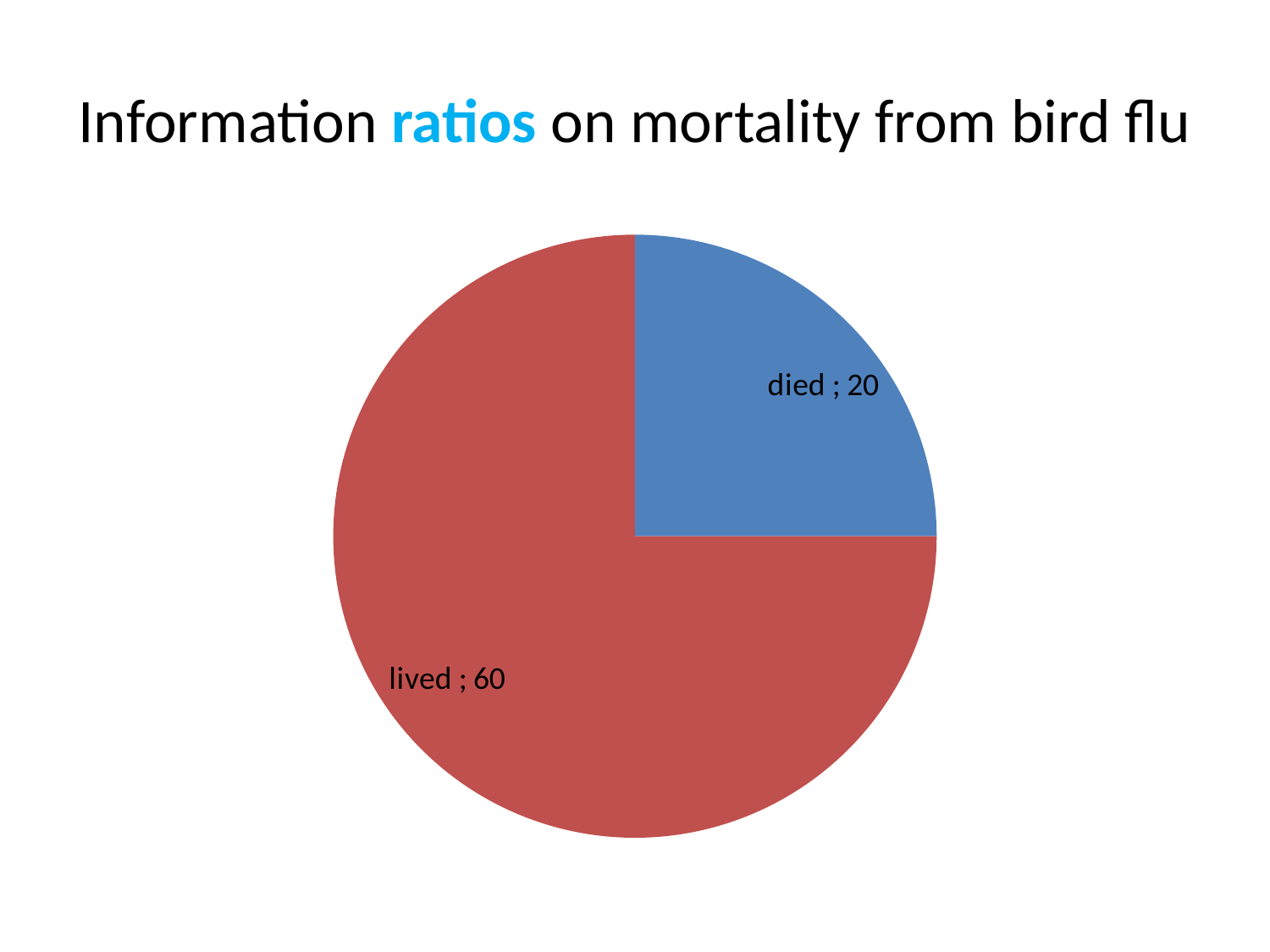
Which slice is the smallest? died What colour is the "died" slice? blue What share of the pie does the "lived" slice represent? 75% Which slice is the largest? lived What kind of chart is shown on the slide? pie chart What share of the pie does the "died" slice represent? 25% What is the value for the "died" slice? 20 What is the total of all slices in the pie chart? 80 What is the difference between the "lived" and "died" values? 40 What is the value for the "lived" slice? 60 How many slices does the pie chart have? 2 Which is larger, the "lived" slice or the "died" slice? lived